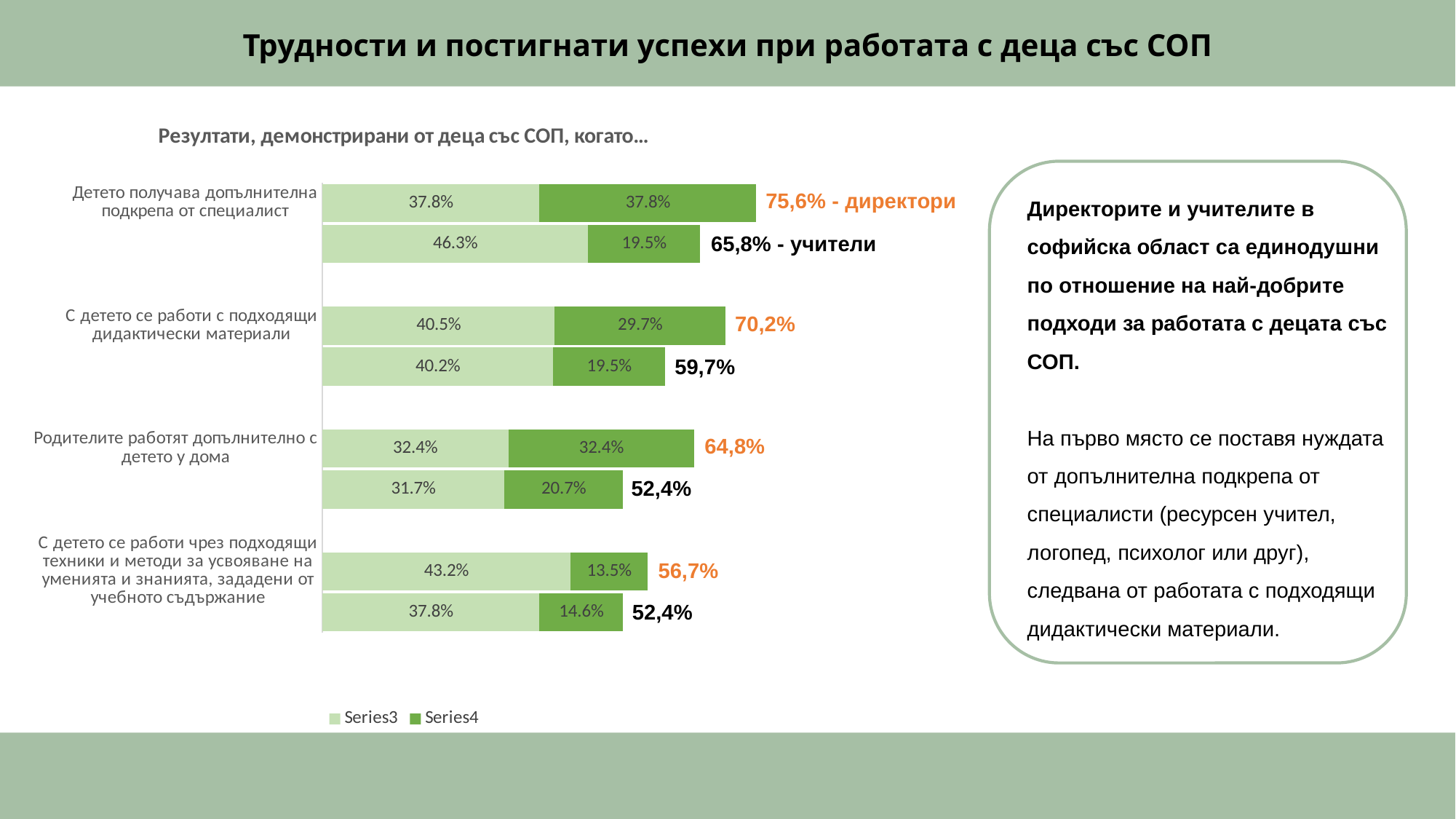
How many categories are shown on the vertical axis of the chart? 4 What is the total shown for the directors' bar for "С детето се работи с подходящи дидактически материали"? 70,2% Which category has the lowest total for directors? С детето се работи чрез подходящи техники и методи за усвояване на уменията и знанията, зададени от учебното съдържание What is the total shown for the teachers' bar for "Родителите работят допълнително с детето у дома"? 52,4% How many series does the legend list? 2 What is the Series3 value on the directors' bar for "Детето получава допълнителна подкрепа от специалист"? 37.8% Which category has the highest total for directors? Детето получава допълнителна подкрепа от специалист What kind of chart is shown on the slide? stacked bar chart What is the Series3 value on the teachers' bar for "С детето се работи с подходящи дидактически материали"? 40.2% What is the Series4 value on the teachers' bar for "Детето получава допълнителна подкрепа от специалист"? 19.5% What is the difference between the directors' total (75,6%) and the teachers' total (65,8%) for "Детето получава допълнителна подкрепа от специалист"? 9,8% For "Родителите работят допълнително с детето у дома", which is larger: the directors' total or the teachers' total? directors' total (64,8%)